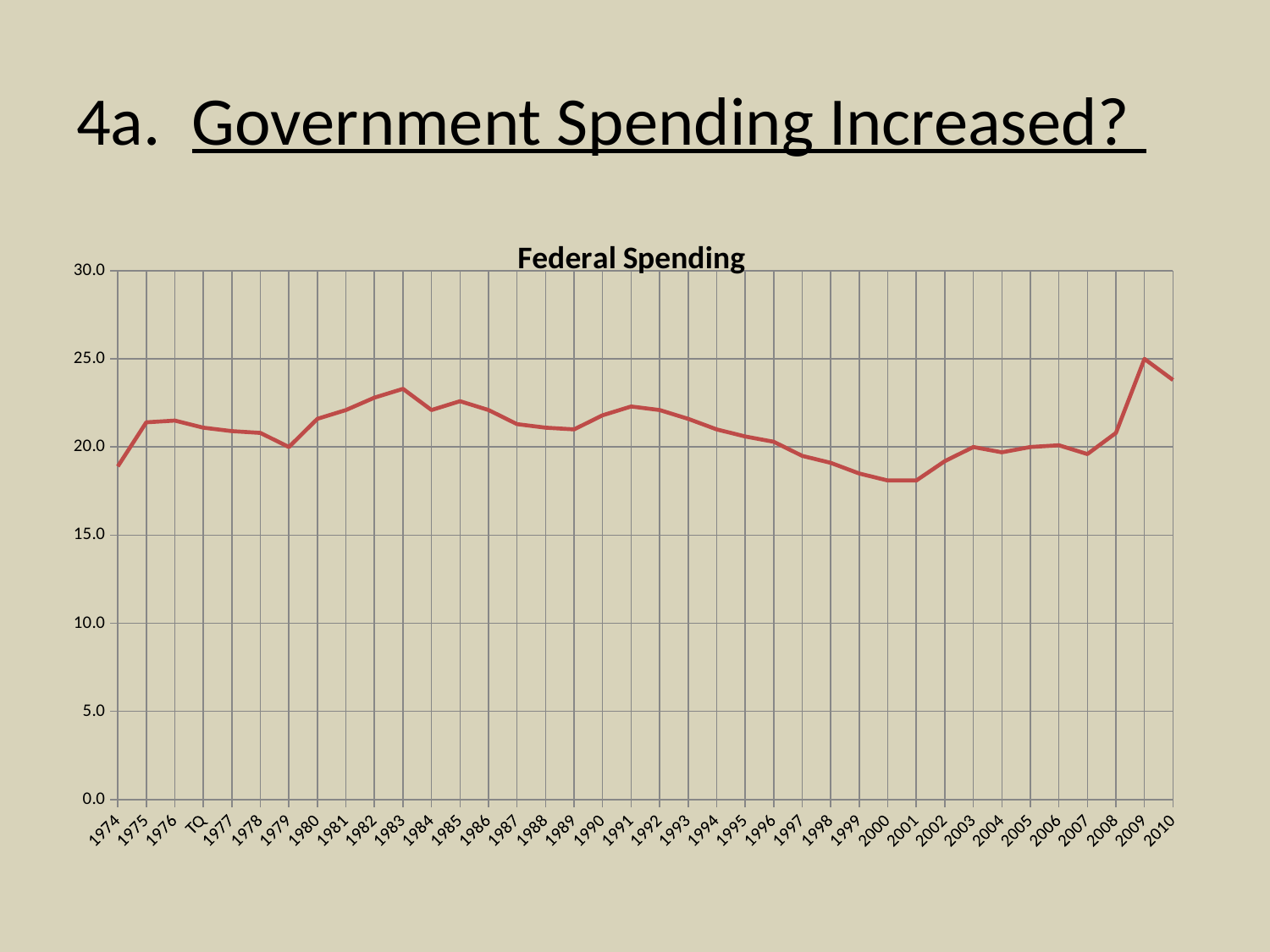
Which year has the highest value in the Federal Spending chart? 2009 Which is larger, the value for 1974 or the value for 1975? 1975 Do the values rise or fall from 2007 to 2009? rise Is the value for 2009 greater or less than 20.0? greater Is the value for 2000 greater or less than 20.0? less Which is larger, the value for 2009 or the value for 2000? 2009 What kind of chart is shown on the slide? line chart Do the values rise or fall from 1991 to 2000? fall Is the value for 1983 greater or less than 20.0? greater How many points are plotted along the x axis of the Federal Spending chart? 38 What is the title of the chart? Federal Spending